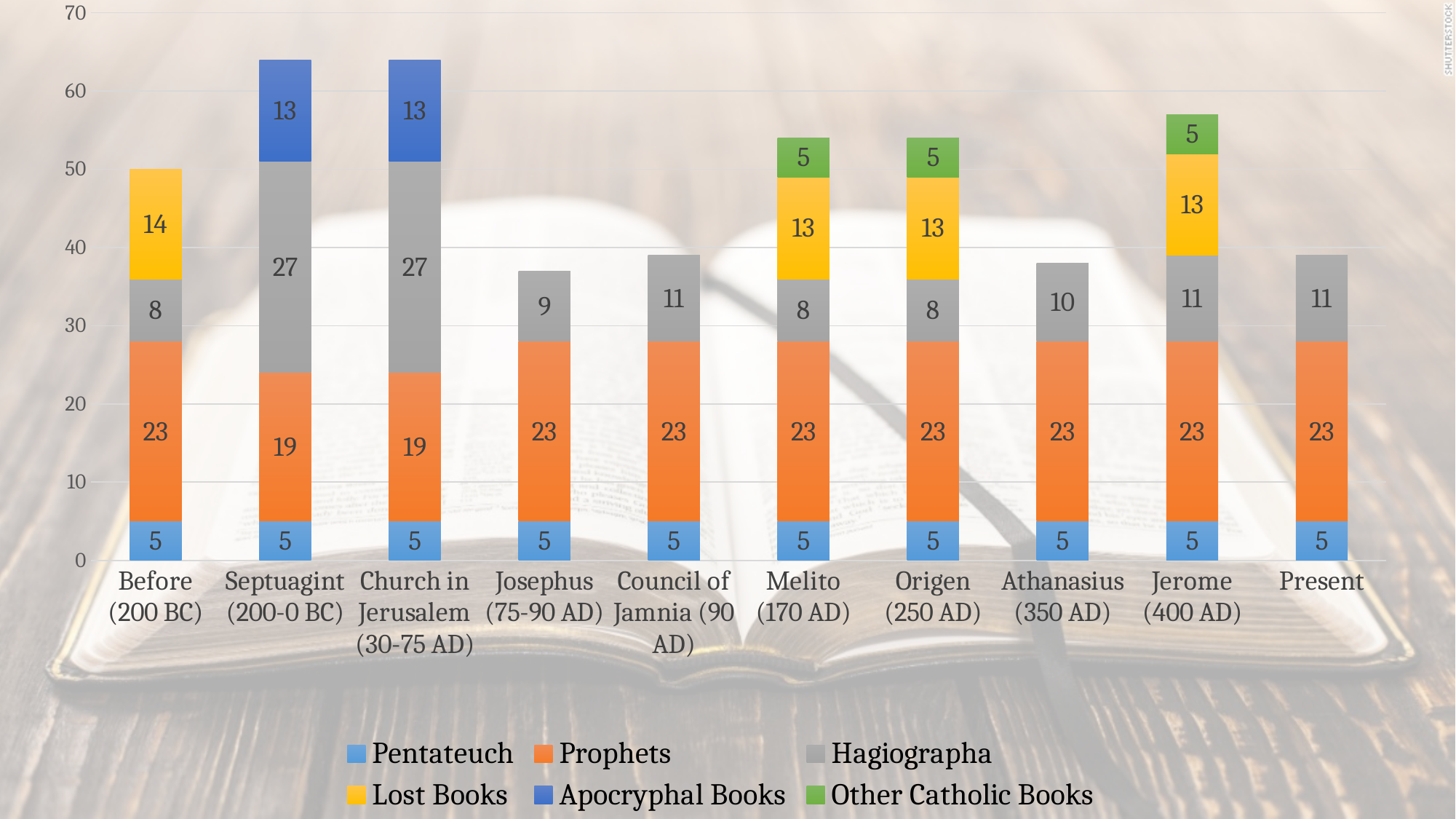
How many series does the legend list? 6 What is the difference between the Hagiographa values for Septuagint (200-0 BC) and Present? 16 What is the Hagiographa value for Athanasius (350 AD)? 10 What is the Prophets value for Church in Jerusalem (30-75 AD)? 19 What is the Other Catholic Books value for Jerome (400 AD)? 5 Which is larger, the Prophets value for Before (200 BC) or for Septuagint (200-0 BC)? Before (200 BC) What is the total of the stacked bar for Jerome (400 AD)? 57 What is the Hagiographa value for Septuagint (200-0 BC)? 27 What is the total of the stacked bar for Josephus (75-90 AD)? 37 How many categories are shown on the x axis? 10 What is the Lost Books value for Before (200 BC)? 14 What kind of chart is shown on the slide? Stacked bar chart